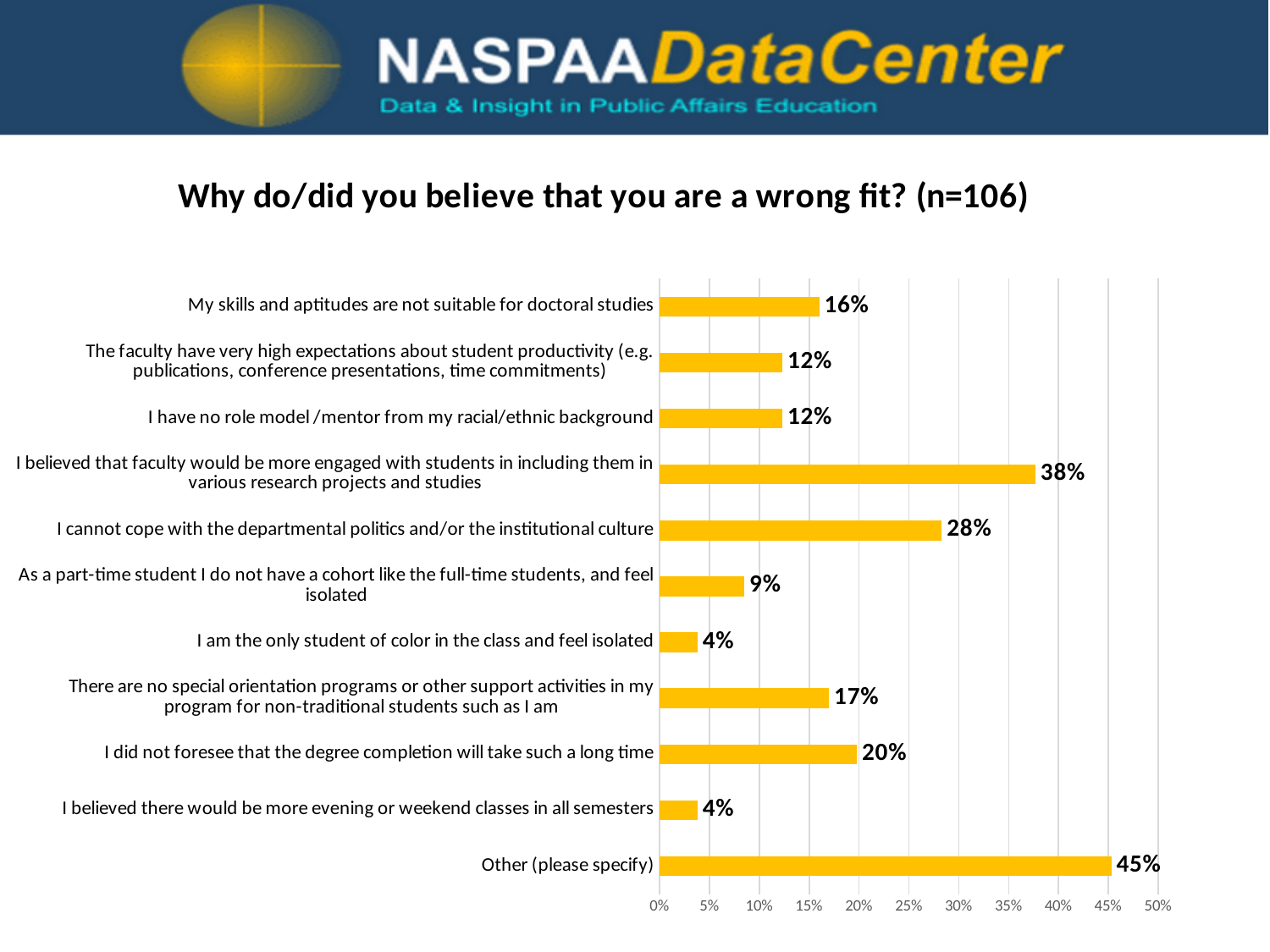
Excluding "Other (please specify)", which reason has the highest percentage? I believed that faculty would be more engaged with students in including them in various research projects and studies What kind of chart is shown on the slide? Bar chart How many reasons (categories) are shown in the chart? 11 Is the value for "I cannot cope with the departmental politics and/or the institutional culture" greater or less than 25%? greater What percentage of respondents selected "Other (please specify)"? 45% What is the difference between "Other (please specify)" and "I believed that faculty would be more engaged with students in including them in various research projects and studies"? 7 percentage points Which reason has the highest percentage? Other (please specify) What is the value for "I cannot cope with the departmental politics and/or the institutional culture"? 28% What is the difference between "I did not foresee that the degree completion will take such a long time" and "I am the only student of color in the class and feel isolated"? 16 percentage points What is the sample size (n) given in the chart title? 106 What percentage chose "I did not foresee that the degree completion will take such a long time"? 20% Which is larger: "My skills and aptitudes are not suitable for doctoral studies" or "There are no special orientation programs or other support activities in my program for non-traditional students such as I am"? There are no special orientation programs or other support activities in my program for non-traditional students such as I am